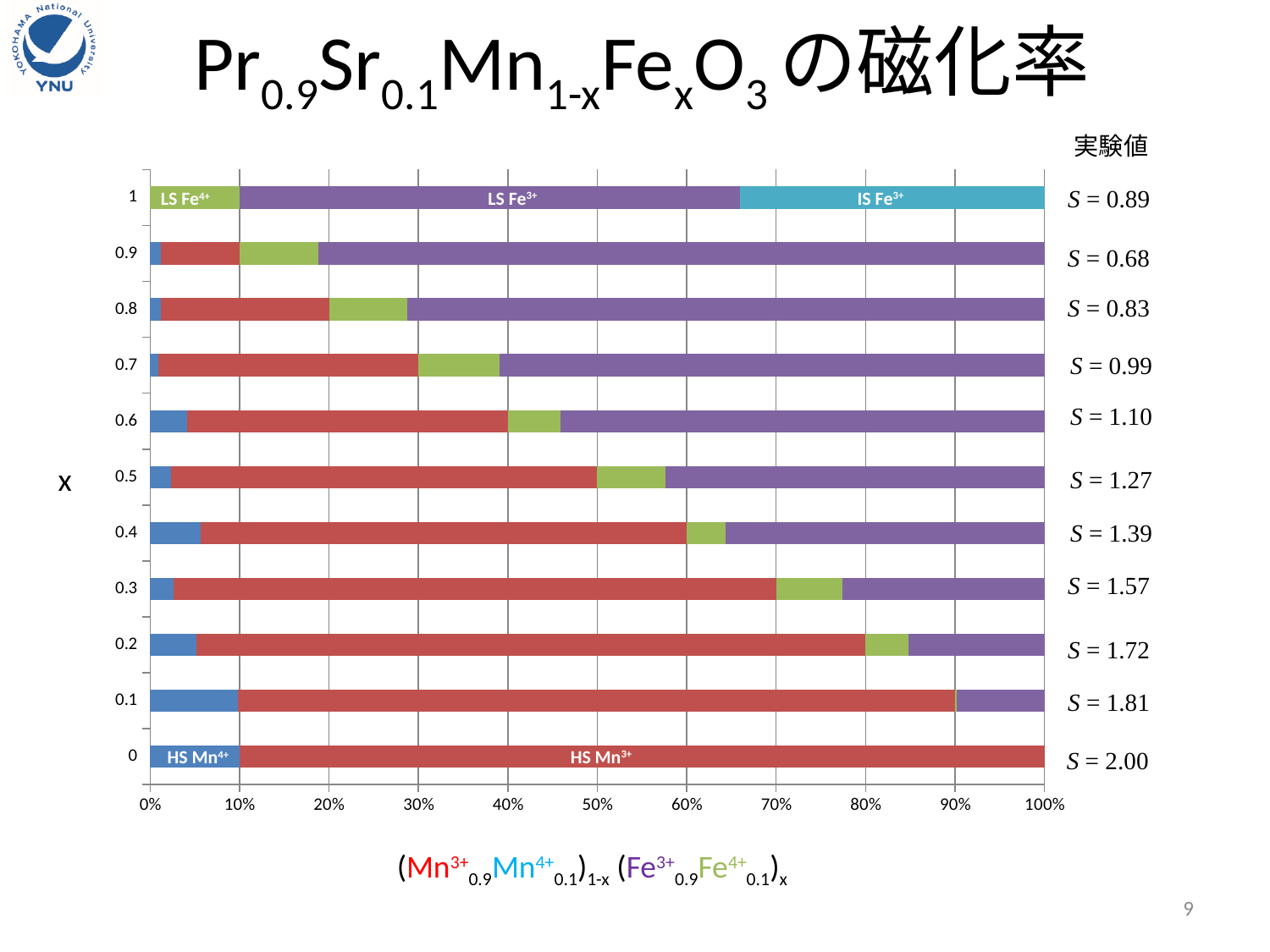
Is the end of the red segment for x = 0.5 greater or less than 40%? greater Which has the larger S value, x = 0.3 or x = 0.7? x = 0.3 How many x categories are plotted on the vertical axis of the chart? 11 Does the experimental S value generally rise or fall as x increases from 0 to 0.9? fall Which x value has the highest experimental S value? 0 What label is printed on the cyan segment of the bar for x = 1? IS Fe3+ What kind of chart is shown on the slide? stacked bar chart Which x value has the lowest experimental S value? 0.9 What is the experimental S value listed for x = 1? S = 0.89 What is the experimental S value listed for x = 0? S = 2.00 What is the experimental S value listed for x = 0.5? S = 1.27 What is the difference between the S value at x = 0 and the S value at x = 1? 1.11